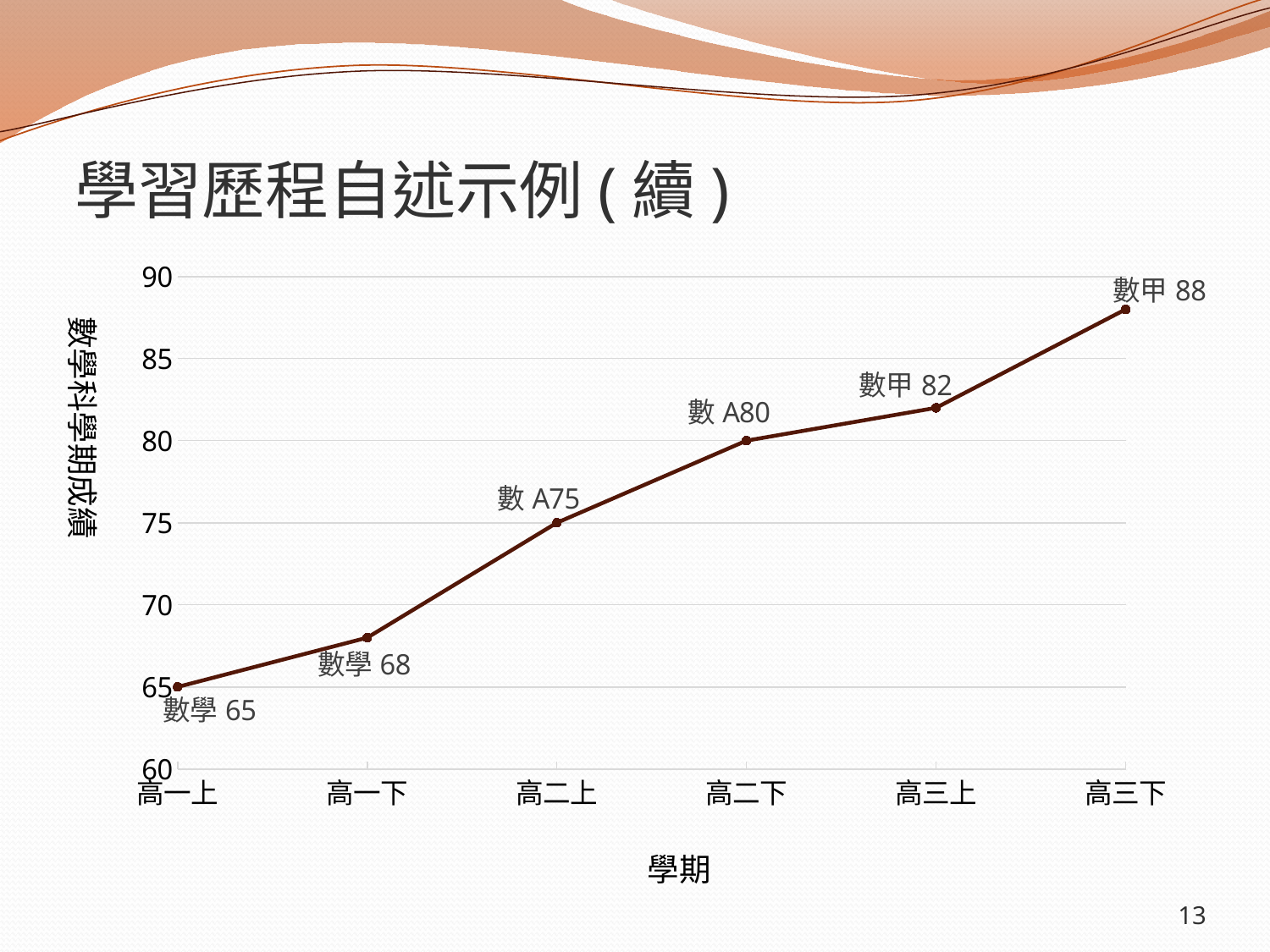
What kind of chart is shown on the slide? line chart What is the difference between the math scores for 高三下 and 高一上? 23 How many semesters are plotted on the chart? 6 Do the math scores rise or fall from 高一上 to 高三下? rise What is the difference between the math scores for 高二上 and 高一下? 7 Which semester has the lowest math score? 高一上 Which semester has the highest math score? 高三下 What is the math score for 高二下? 80 Is the math score for 高一下 greater or less than 70? less What is the math score for 高一上? 65 Which is higher, the math score for 高三上 or for 高二下? 高三上 What is the math score for 高三下? 88